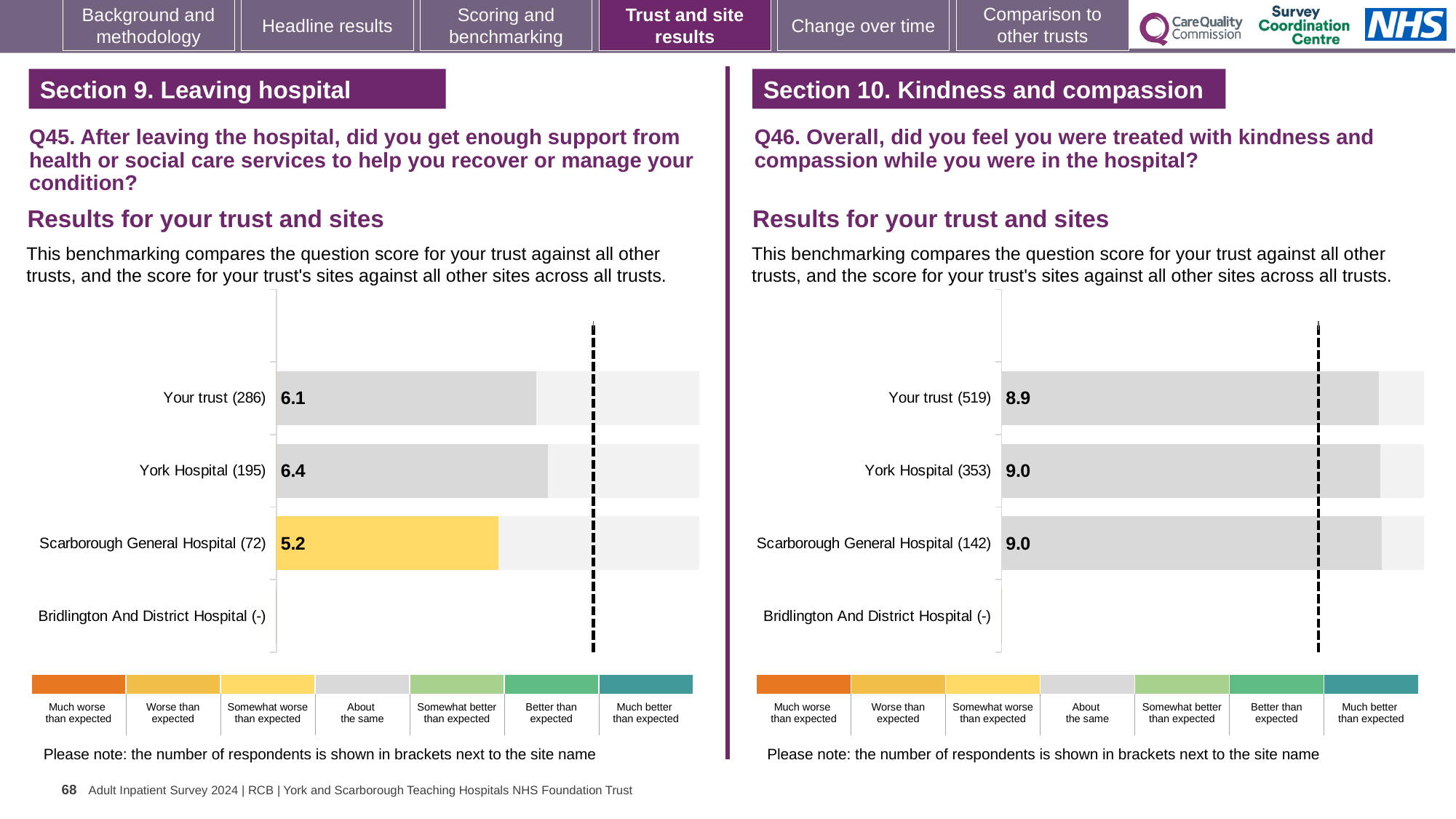
In the Q46 chart (right), how many respondents are shown for Scarborough General Hospital? 142 In the Q45 chart (left), which site has the lowest score? Scarborough General Hospital In the Q46 chart (right), what is the score for Your trust? 8.9 In the Q45 chart (left), what is the score for Scarborough General Hospital? 5.2 In the Q46 chart (right), is the score for Your trust larger or smaller than the score for York Hospital? smaller What kind of chart is used on the left for Q45? bar chart In the Q46 chart (right), what is the score for York Hospital? 9.0 In the Q45 chart (left), how many respondents are shown for Your trust? 286 In the Q45 chart (left), what is the difference between the York Hospital score and the Scarborough General Hospital score? 1.2 In the Q45 chart (left), what is the score for Your trust? 6.1 In the Q45 chart (left), which site's bar is coloured yellow? Scarborough General Hospital In the Q45 chart (left), which site has the highest score? York Hospital